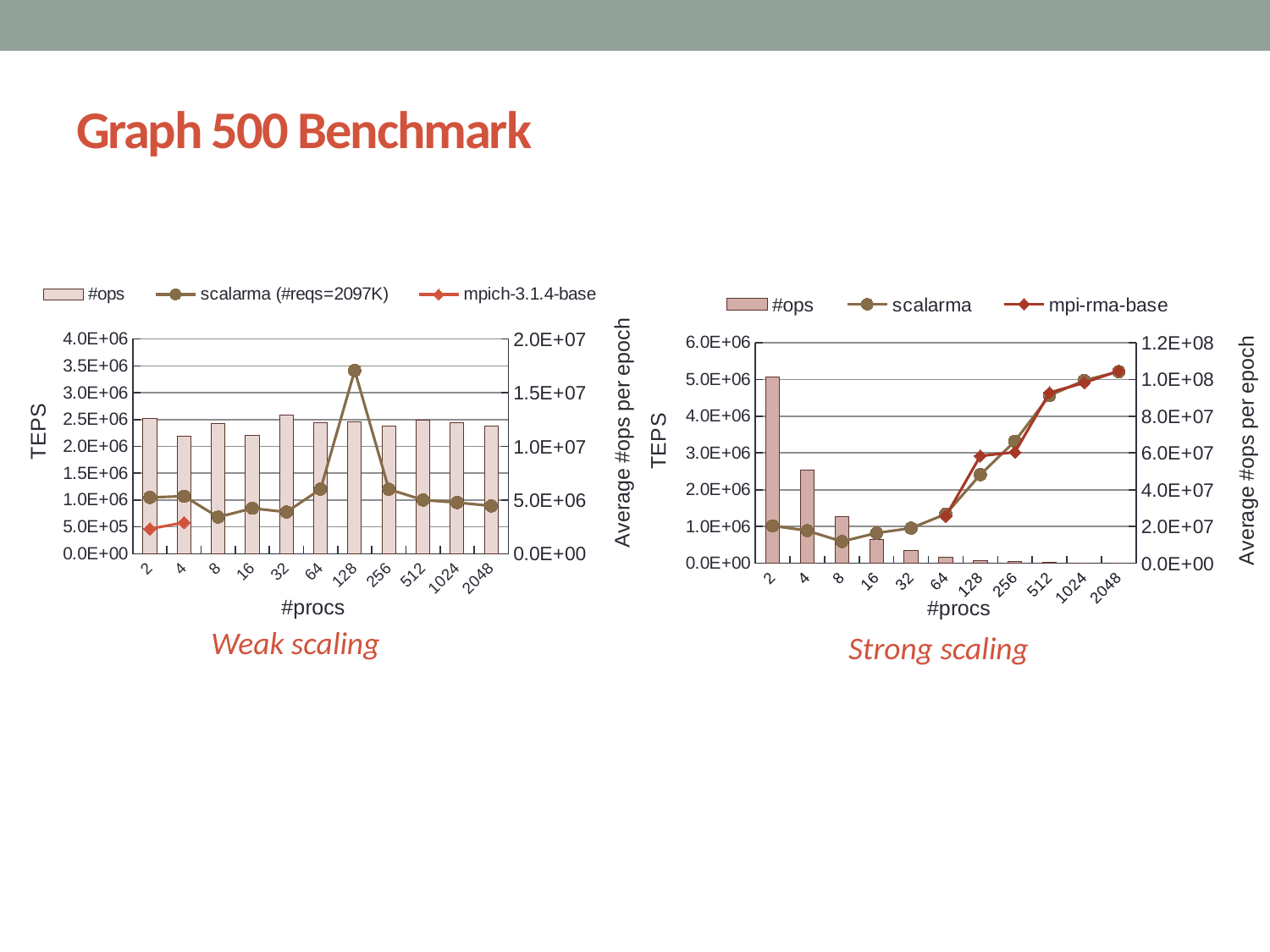
In the Strong scaling chart, is the scalarma value at 2048 procs greater or less than 1.0E+08 on the right axis? greater In the Strong scaling chart, is the #ops bar at 2 procs greater or less than 4.0E+06 on the left axis? greater In the Strong scaling chart, does the scalarma line rise or fall from 64 procs to 2048 procs? rises In the Strong scaling chart, how many series does the legend list? 3 In the Weak scaling chart, at which #procs value does the scalarma line reach its highest point? 128 What is the title of the right-hand vertical axis in the Weak scaling chart? Average #ops per epoch In the Strong scaling chart, which #ops bar is taller, the one at 2 procs or the one at 4 procs? 2 procs In the Weak scaling chart, is the scalarma value at 128 procs greater or less than 1.5E+07 on the right axis? greater In the Weak scaling chart, how many series does the legend list? 3 In the Strong scaling chart, at which #procs value is the #ops bar tallest? 2 What kind of chart is the Weak scaling chart? combined bar and line chart How many #procs categories are shown on the x axis of the Strong scaling chart? 11